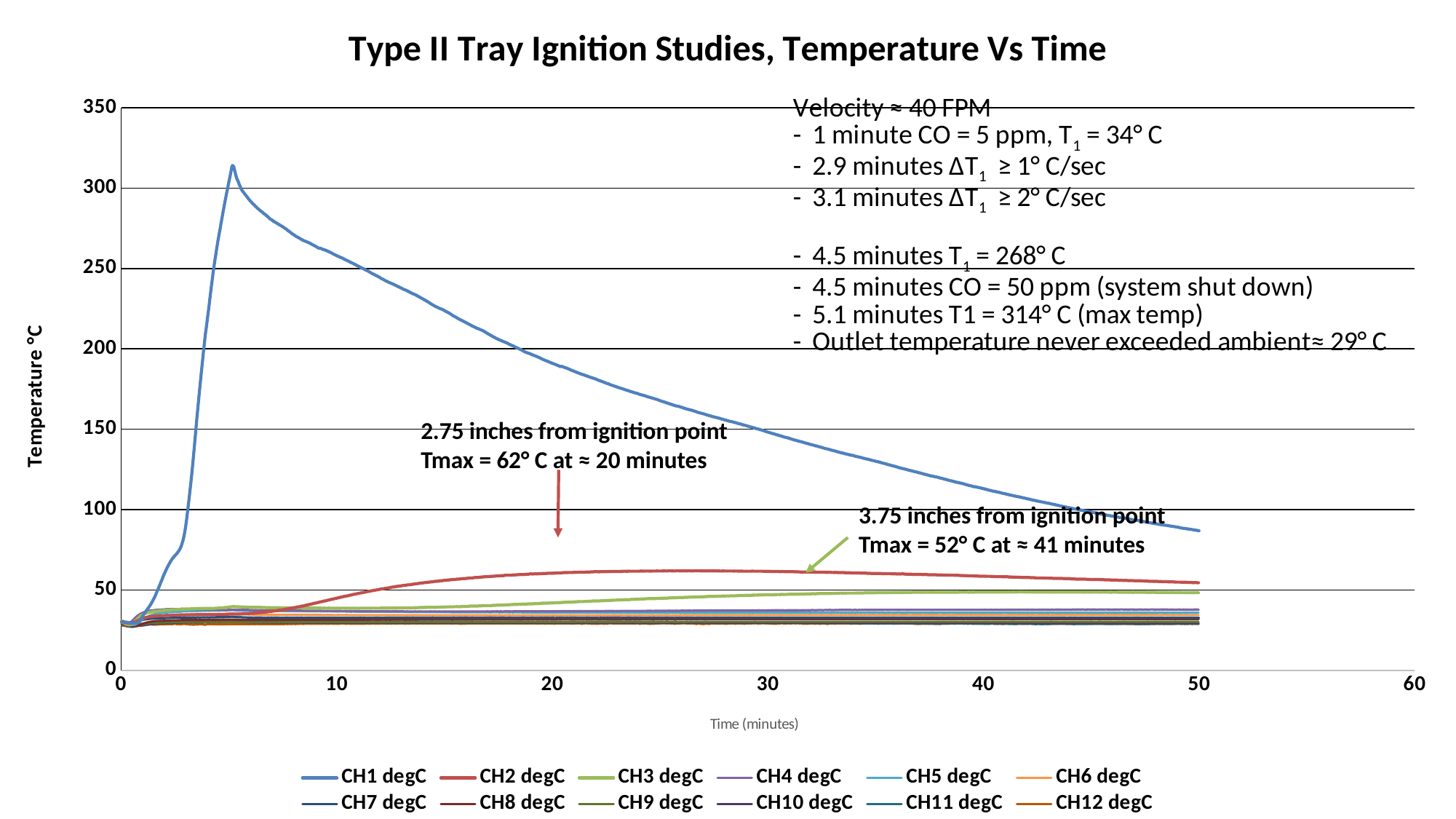
What type of chart is shown on the slide? line chart What is the title of the chart? Type II Tray Ignition Studies, Temperature Vs Time After its peak at about 5 minutes, does CH1 degC rise or fall as time increases? fall Is the value of CH1 degC at 50 minutes greater or less than 100? less According to the annotation, what is the Tmax for the sensor 3.75 inches from the ignition point? 52° C Which series reaches the highest temperature on the chart? CH1 degC Is the value of CH1 degC at 10 minutes greater or less than 250? greater At 20 minutes, which is higher: CH2 degC or CH3 degC? CH2 degC Is the value of CH1 degC at 40 minutes greater or less than 100? greater According to the annotation, what is the Tmax for the sensor 2.75 inches from the ignition point? 62° C How many series does the legend list? 12